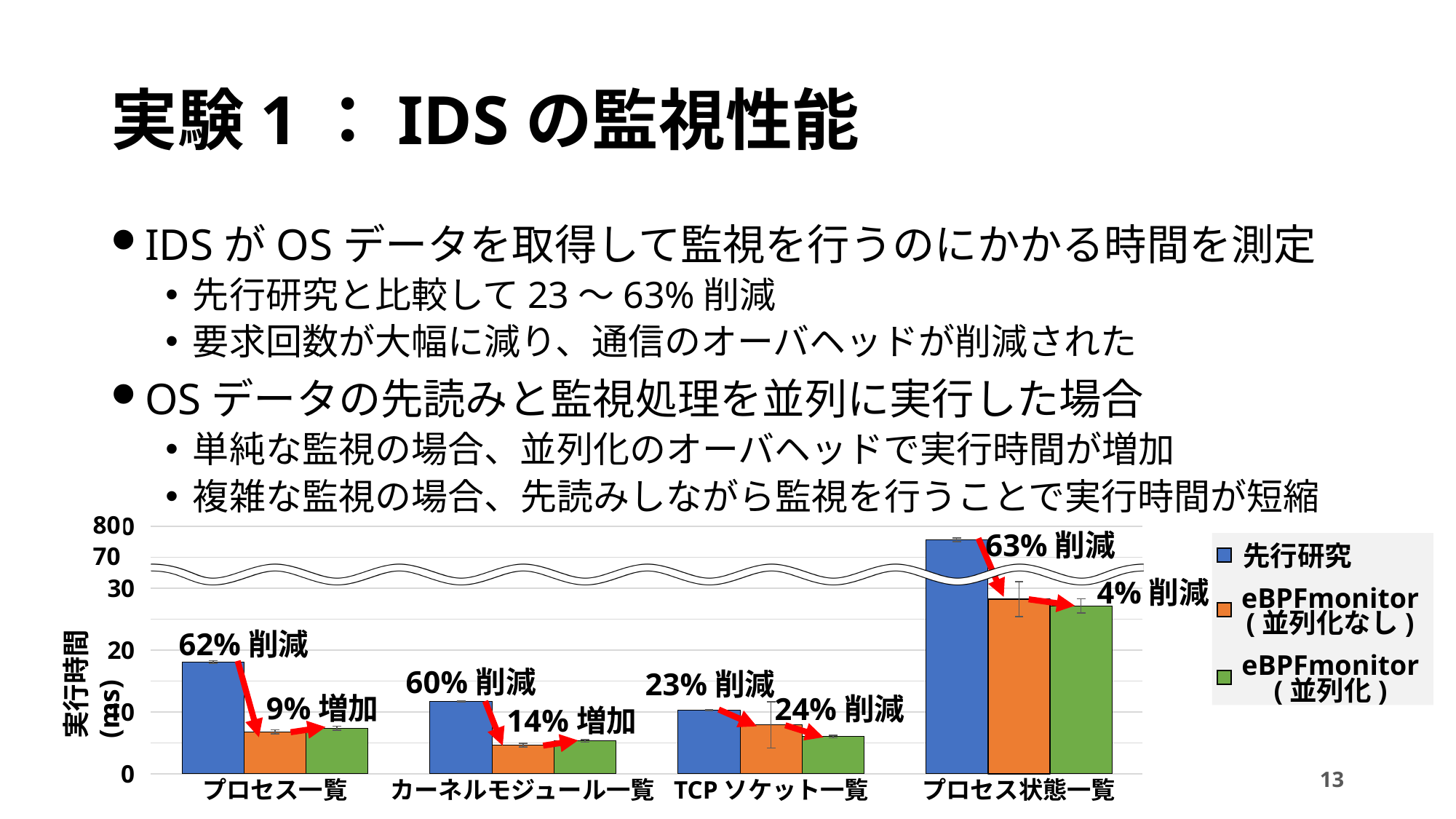
What percentage change is annotated between eBPFmonitor (並列化なし) and eBPFmonitor (並列化) for カーネルモジュール一覧? 14% 増加 What is the label of the y axis of the chart? 実行時間 (ms) What kind of chart is shown on the slide? bar chart What percentage change is annotated between 先行研究 and eBPFmonitor (並列化なし) for プロセス一覧? 62% 削減 How many categories are shown on the x axis of the chart? 4 Which category has the highest 先行研究 bar? プロセス状態一覧 How many series does the chart's legend list? 3 For プロセス一覧, which is larger: the 先行研究 value or the eBPFmonitor (並列化なし) value? 先行研究 What percentage change is annotated between eBPFmonitor (並列化なし) and eBPFmonitor (並列化) for TCP ソケット一覧? 24% 削減 Which series is shown in orange in the chart? eBPFmonitor (並列化なし) Is the 先行研究 value for プロセス一覧 greater or less than 20? less What percentage change is annotated between 先行研究 and eBPFmonitor (並列化なし) for プロセス状態一覧? 63% 削減